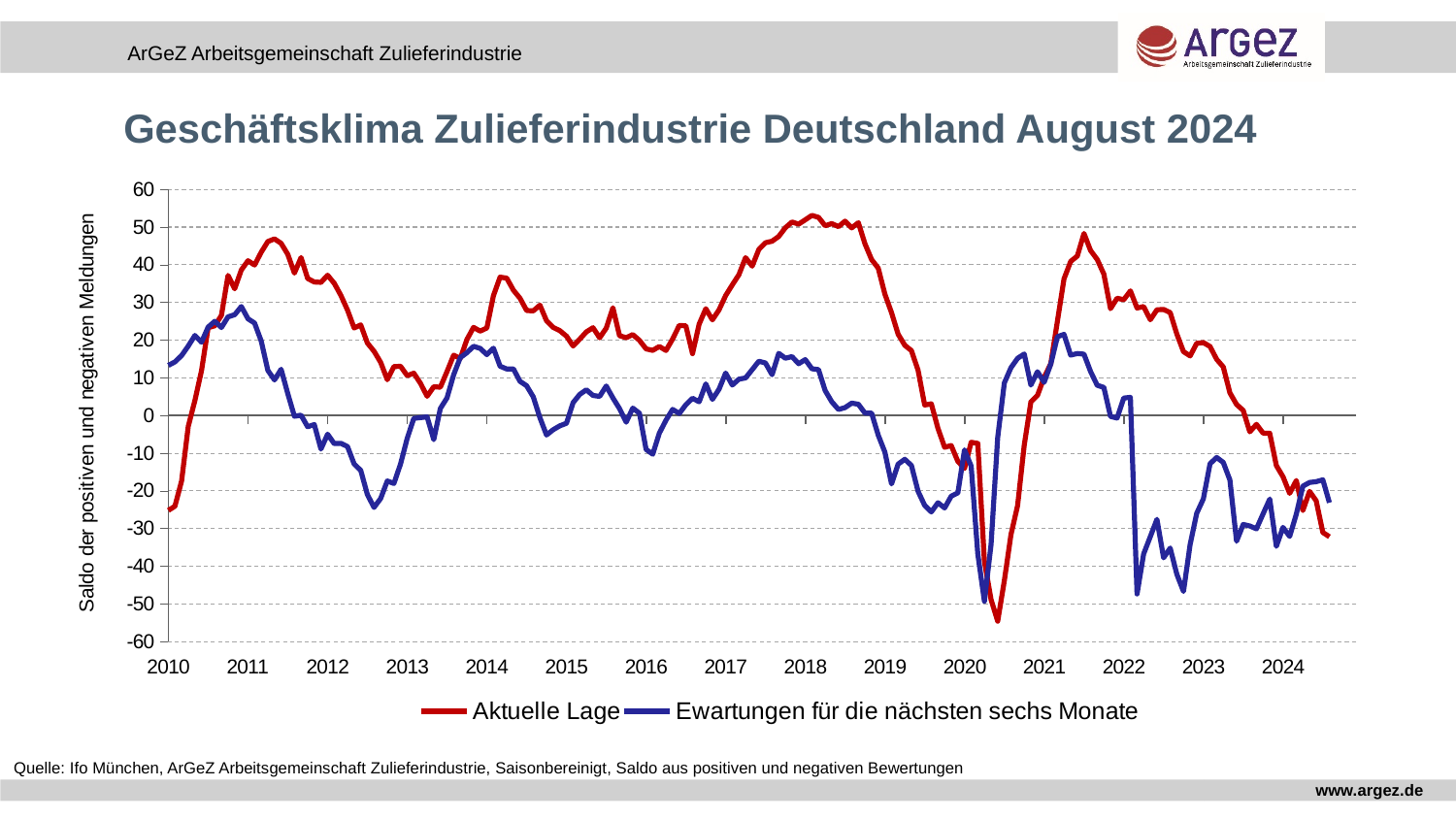
Is the lowest value of 'Aktuelle Lage' in 2020 greater or less than -40? less At the start of 2022, which series has the higher value, 'Aktuelle Lage' or 'Ewartungen für die nächsten sechs Monate'? Aktuelle Lage Is the lowest value of 'Ewartungen für die nächsten sechs Monate' in 2022 greater or less than -40? less Does the 'Aktuelle Lage' series rise or fall from its 2021 peak to 2024? fall Is the peak value of 'Aktuelle Lage' in 2018 greater or less than 40? greater How many year labels are shown on the x axis? 15 How many series does the legend list? 2 What is the title of the chart? Geschäftsklima Zulieferindustrie Deutschland August 2024 Which colour is used for the 'Aktuelle Lage' series? red Which series reaches the highest value anywhere on the chart? Aktuelle Lage What kind of chart is shown on the slide? line chart